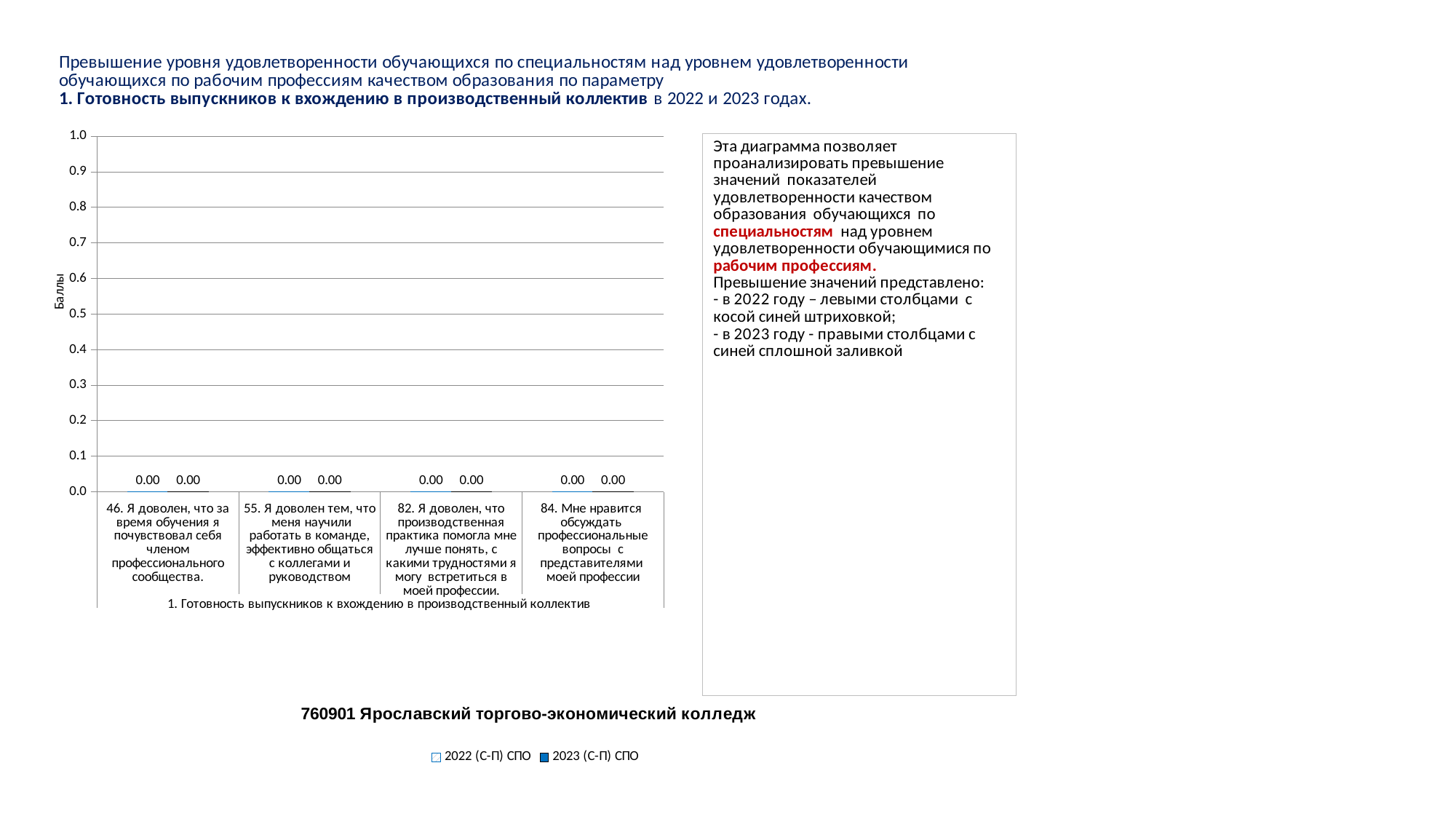
What are the two legend entries of the chart? 2022 (С-П) СПО and 2023 (С-П) СПО What is the value for 2022 (С-П) СПО in category 82 (Я доволен, что производственная практика помогла мне лучше понять, с какими трудностями я могу встретиться в моей профессии)? 0.00 How many categories are shown on the x axis of the chart? 4 What is the value for 2023 (С-П) СПО in category 84 (Мне нравится обсуждать профессиональные вопросы с представителями моей профессии)? 0.00 What is the value for 2022 (С-П) СПО in category 46 (Я доволен, что за время обучения я почувствовал себя членом профессионального сообщества)? 0.00 Do the values for 2022 (С-П) СПО rise, fall, or stay the same across the categories on the x axis? stay the same Is the value for 2023 (С-П) СПО in category 82 greater or less than 0.5? less What is the value for 2023 (С-П) СПО in category 55 (Я доволен тем, что меня научили работать в команде, эффективно общаться с коллегами и руководством)? 0.00 What is the label of the vertical axis of the chart? Баллы What is the difference between the 2022 (С-П) СПО and 2023 (С-П) СПО values in category 46? 0.00 How many series does the chart legend list? 2 What type of chart is shown on the slide? bar chart